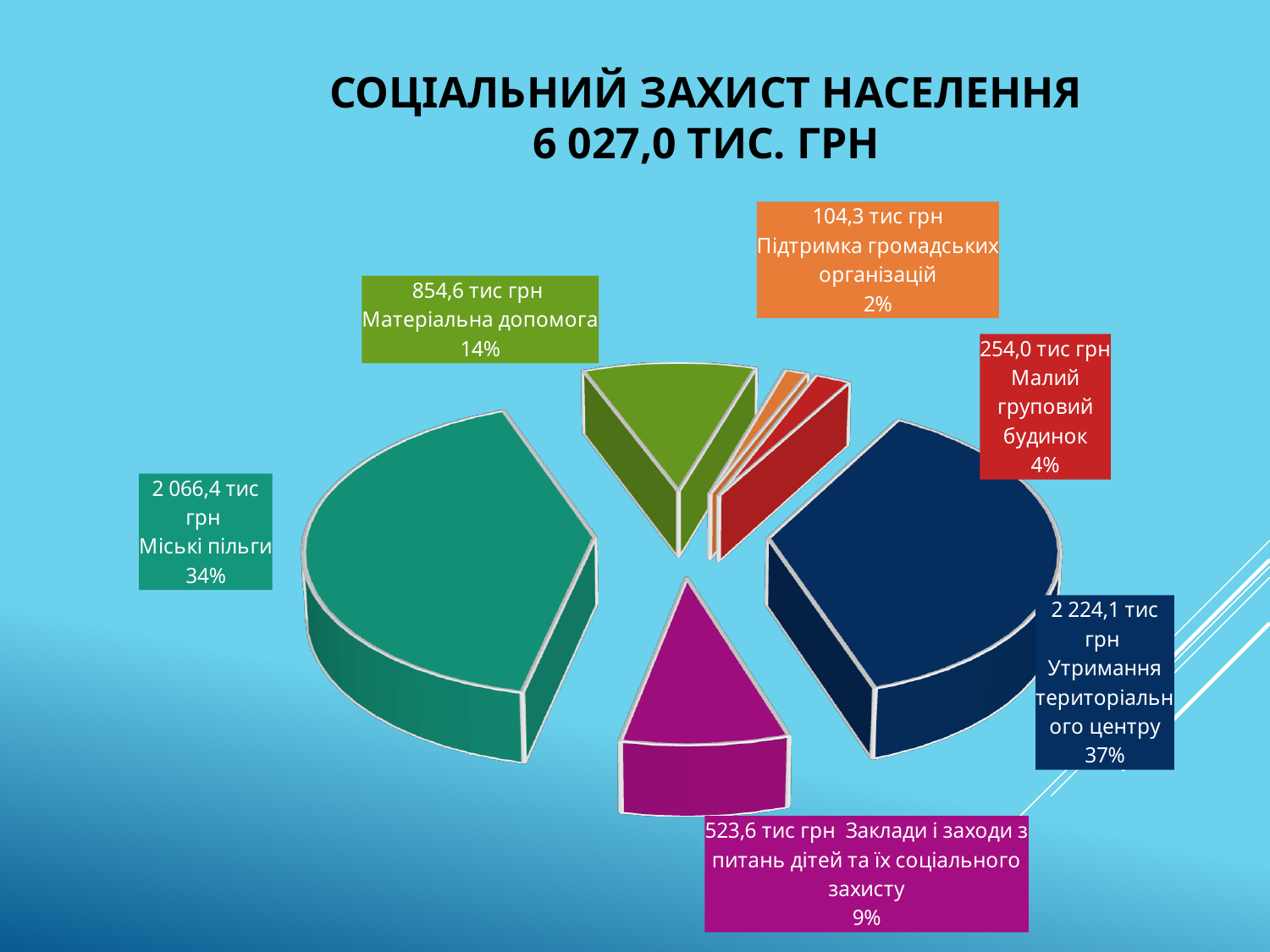
Which category has the largest slice? Утримання територіального центру What is the value for Міські пільги? 2 066,4 тис грн What is the difference between the values for Утримання територіального центру and Міські пільги? 157,7 тис грн What is the value for Матеріальна допомога? 854,6 тис грн What share of the pie does Малий груповий будинок represent? 4% What is the value for Утримання територіального центру? 2 224,1 тис грн What total amount is stated in the chart title? 6 027,0 тис. грн What share of the pie does Заклади і заходи з питань дітей та їх соціального захисту represent? 9% How many slices does the pie chart have? 6 What kind of chart is shown on the slide? Pie chart Which is larger, the value for Матеріальна допомога or the value for Заклади і заходи з питань дітей та їх соціального захисту? Матеріальна допомога Which category has the smallest slice? Підтримка громадських організацій